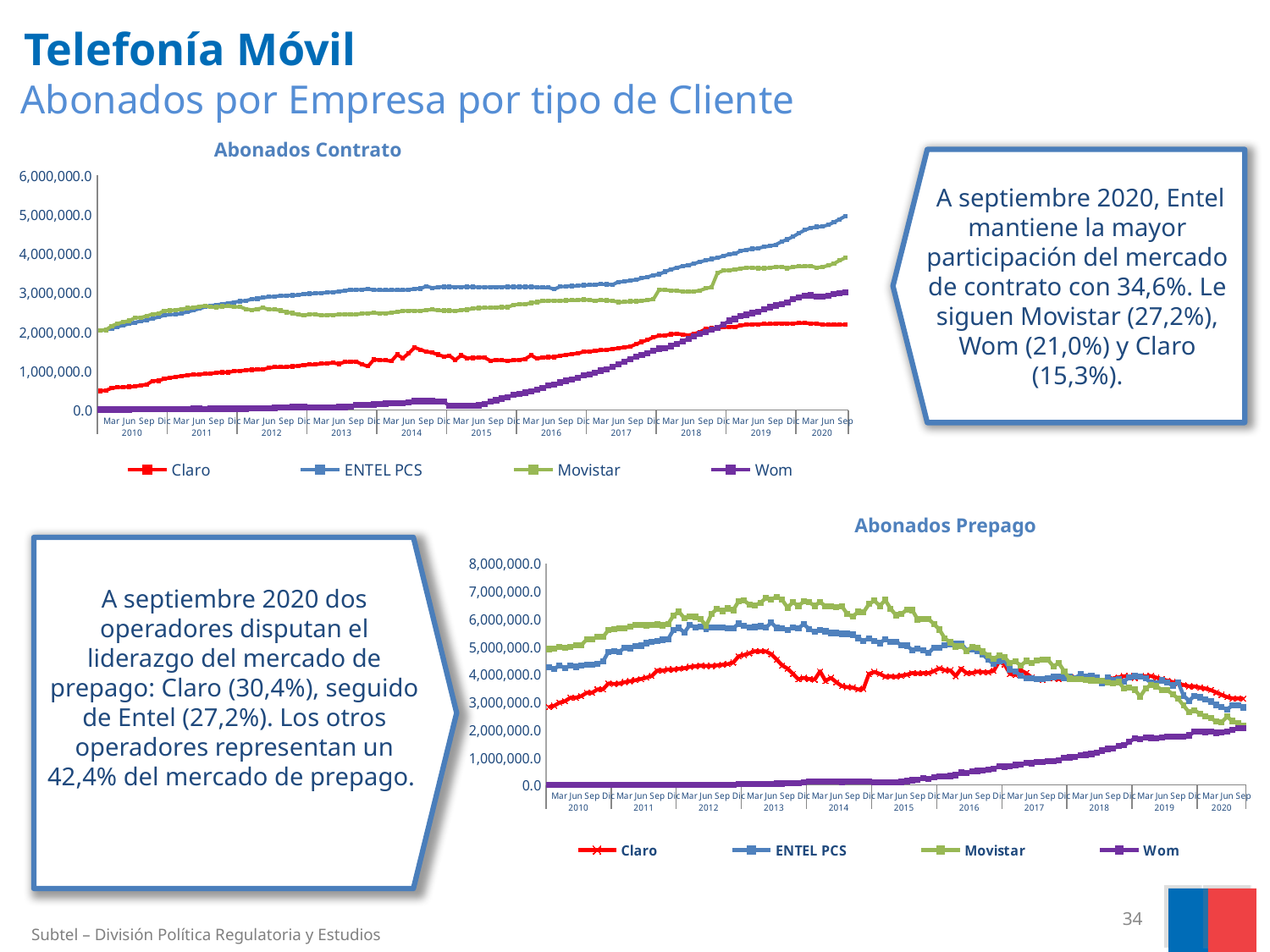
In the 'Abonados Contrato' chart, which operator has the highest number of subscribers at Sep 2020? ENTEL PCS What is the title of the top chart on the slide? Abonados Contrato In the 'Abonados Prepago' chart, is the value for Wom at Sep 2020 greater or less than 3,000,000? less In the 'Abonados Contrato' chart, is the value for ENTEL PCS at Sep 2020 greater or less than 4,000,000? greater In the 'Abonados Prepago' chart, does the Movistar line rise or fall from 2013 to 2020? fall In the 'Abonados Contrato' chart, is the value for Claro at Sep 2020 greater or less than 3,000,000? less How many series does the legend of the 'Abonados Prepago' chart list? 4 In the 'Abonados Contrato' chart, does the Wom line rise or fall from 2015 to 2020? rise In the 'Abonados Prepago' chart, which is larger at Sep 2020: Claro or Wom? Claro In the 'Abonados Contrato' chart, which operator has the lowest number of subscribers in 2010? Wom What kind of chart is the 'Abonados Contrato' chart? line chart